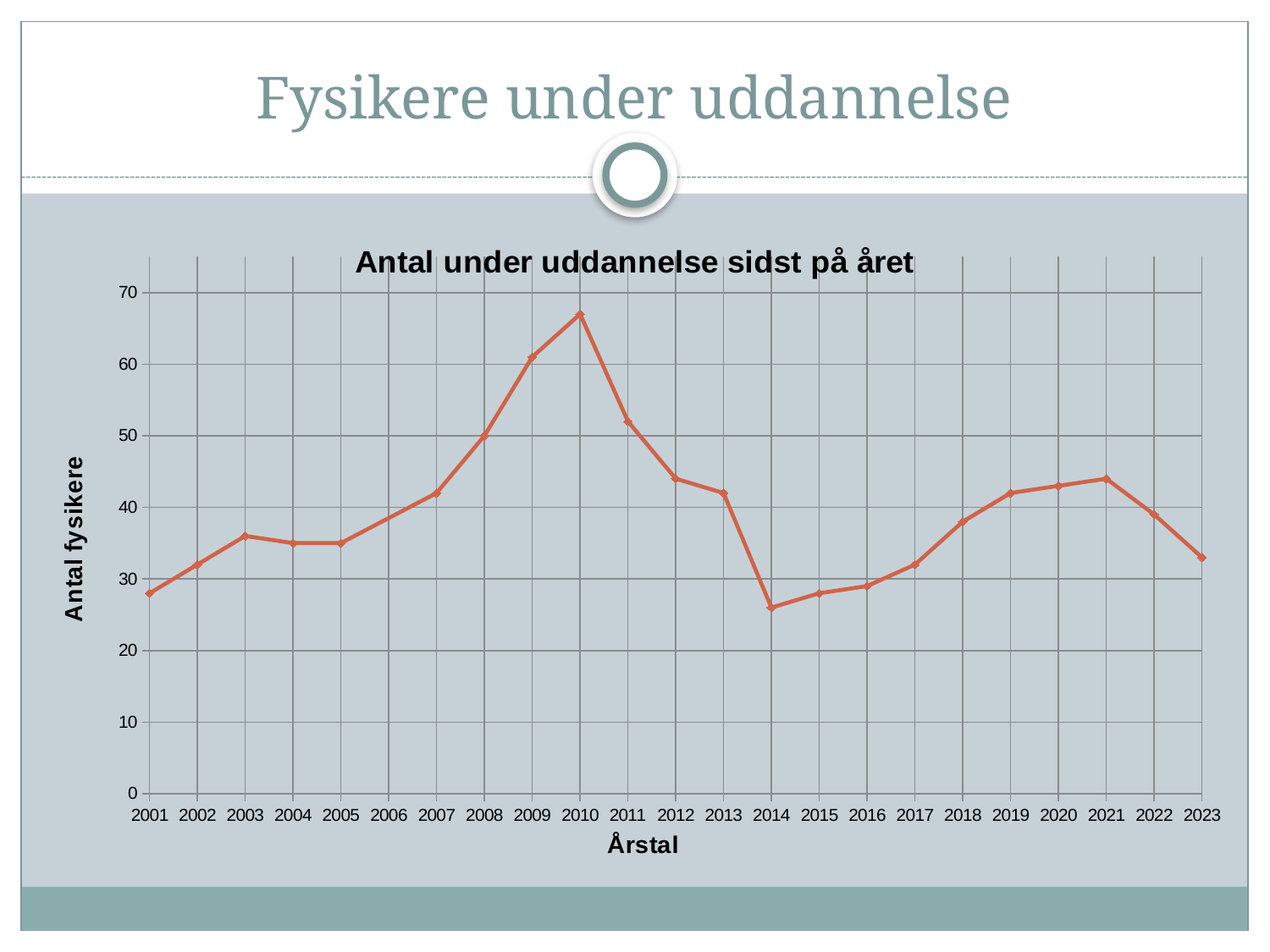
What is the label of the vertical axis? Antal fysikere What kind of chart is shown on the slide? line chart Is the value for 2001 greater or less than 30? less What is the title of the chart? Antal under uddannelse sidst på året Is the value for 2010 greater or less than 60? greater In which year is the number of physicists under education highest? 2010 Is the value for 2014 greater or less than 30? less How many years are plotted along the x axis? 23 Do the values rise or fall from 2010 to 2014? fall Do the values rise or fall from 2001 to 2010? rise Which year has the larger value, 2010 or 2014? 2010